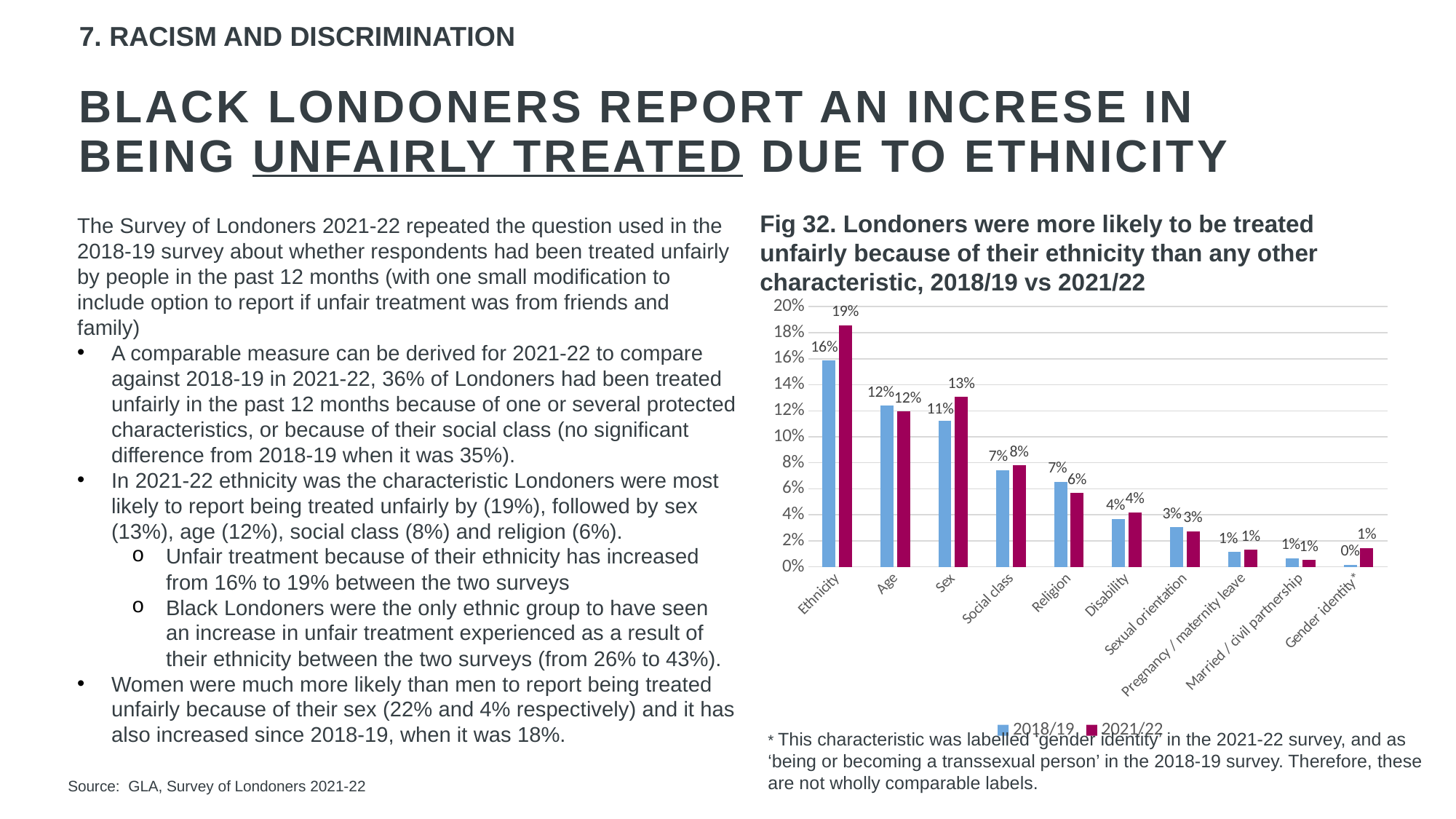
In Fig 32, which series is shown in dark magenta? 2021/22 In Fig 32, what is the difference between the 2021/22 and 2018/19 values for Ethnicity? 3% In Fig 32, which characteristic has the highest 2021/22 value? Ethnicity In Fig 32, what is the 2021/22 value for Social class? 8% In Fig 32, what is the 2018/19 value for Sex? 11% In Fig 32, which is larger for Religion: the 2018/19 value or the 2021/22 value? 2018/19 In Fig 32, what is the 2021/22 value for Ethnicity? 19% In Fig 32, is the 2021/22 value for Sex greater or less than 10%? greater In Fig 32, which characteristic has the lowest 2018/19 value? Gender identity* How many series does the legend of Fig 32 list? 2 What kind of chart is shown in Fig 32? Bar chart How many characteristics (categories) are shown on the x axis of Fig 32? 10